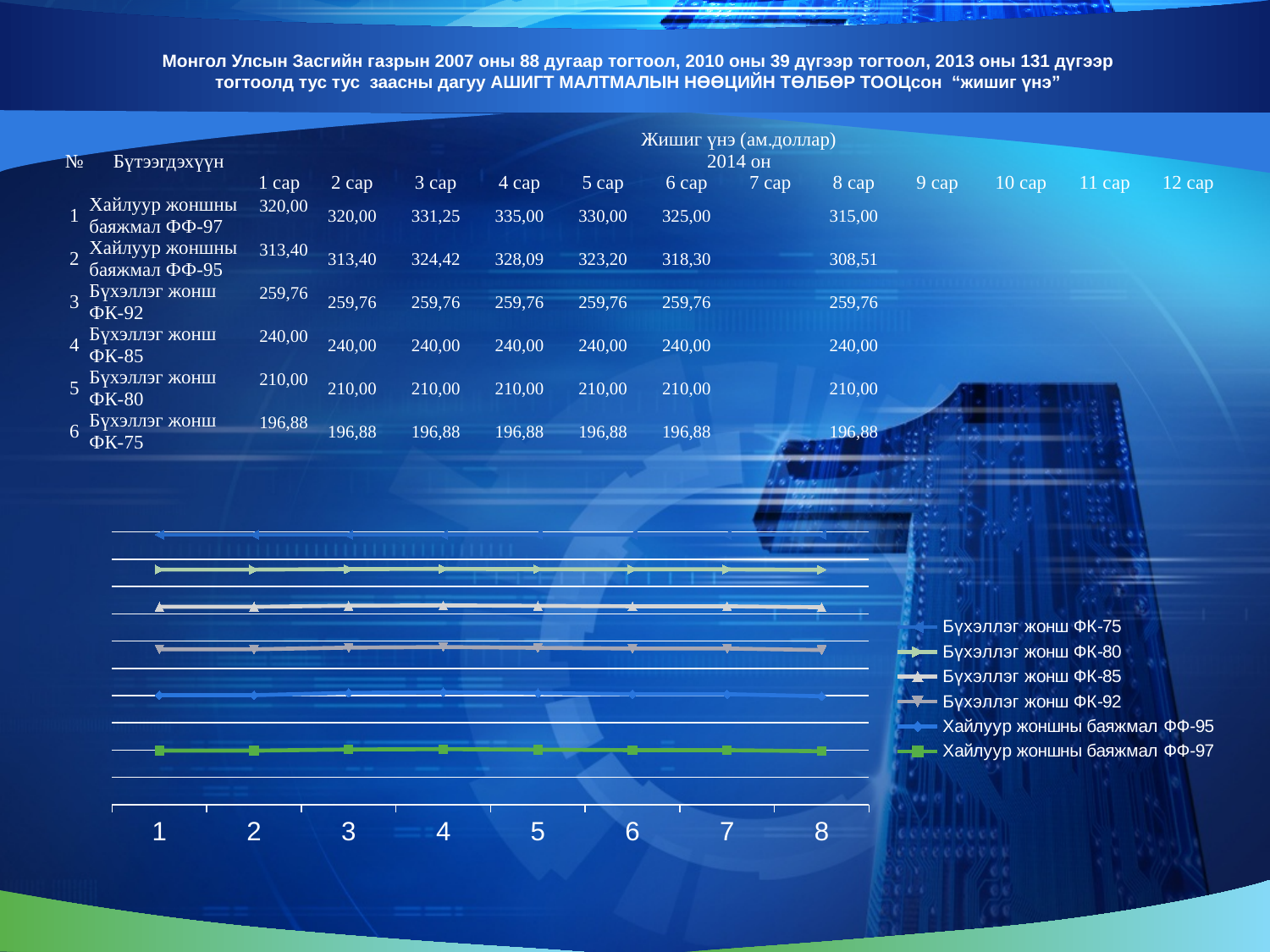
What is the last label on the chart's x axis? 8 What is the first label on the chart's x axis? 1 Does the line for Бүхэллэг жонш ФК-80 rise, fall, or stay flat across the x axis? stay flat Does the line for Бүхэллэг жонш ФК-75 rise, fall, or stay flat across the x axis? stay flat How many points are labelled along the x axis of the chart? 8 Does the line for Бүхэллэг жонш ФК-92 rise, fall, or stay flat across the x axis? stay flat How many series does the chart legend list? 6 What kind of chart is shown at the bottom of the slide? line chart